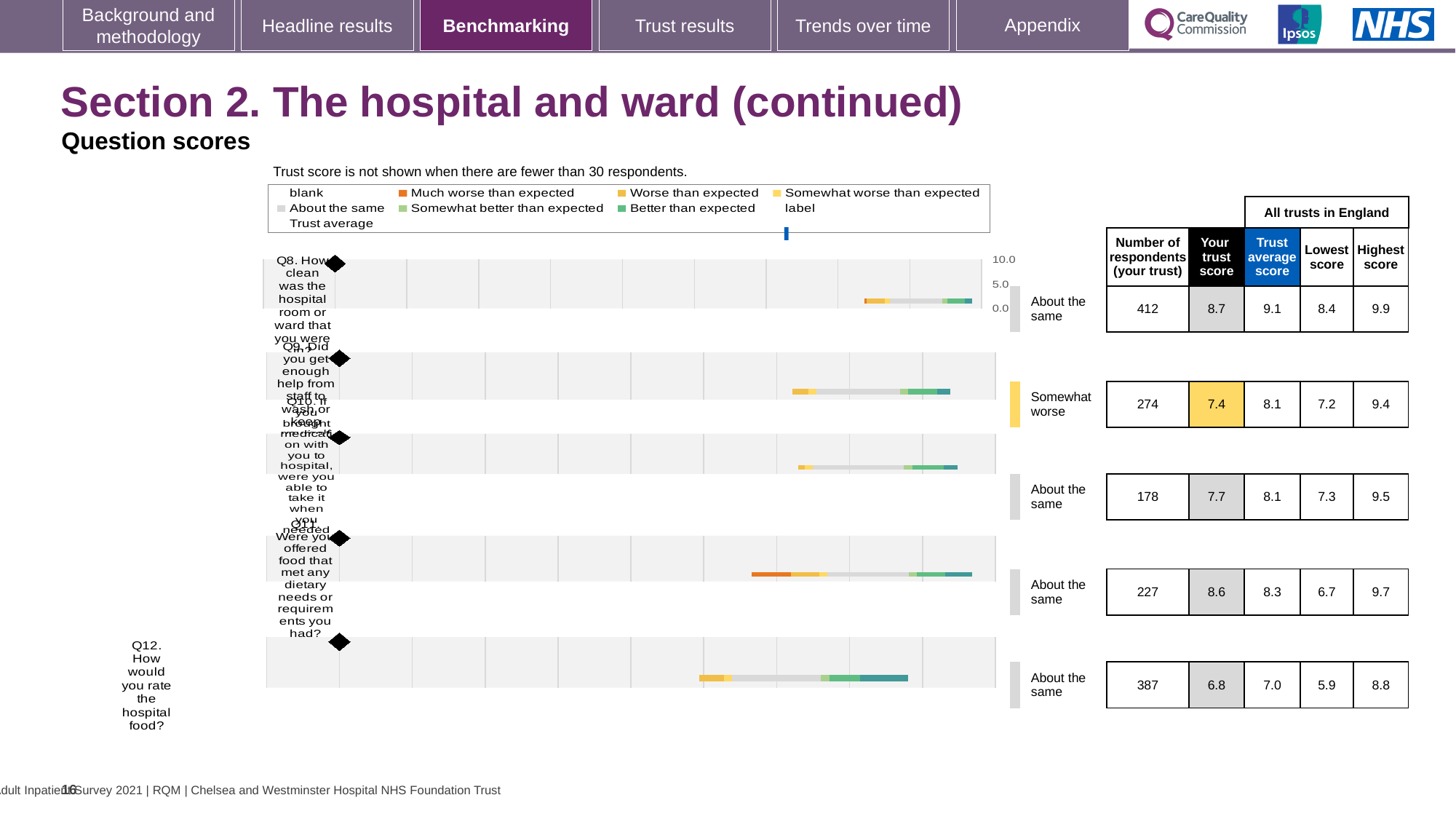
What is the 'Trust average score' for Q9 (Did you get enough help from staff to wash or keep yourself clean)? 8.1 For Q12, what is the difference between the 'Highest score' and the 'Lowest score'? 2.9 Which question has the lowest 'Your trust score'? Q12 Which benchmark category is shown for Q9? Somewhat worse For Q11, which is larger: 'Your trust score' or the 'Trust average score'? Your trust score What is the 'Your trust score' for Q8 (How clean was the hospital room or ward that you were in)? 8.7 What is the 'Highest score' across all trusts in England for Q8? 9.9 What kind of chart is used to show the question scores? Bar chart How many respondents from your trust answered Q12 (How would you rate the hospital food)? 387 For Q9, what is the difference between the 'Trust average score' and 'Your trust score'? 0.7 How many questions are shown in the chart? 5 Which question has the highest 'Your trust score'? Q8